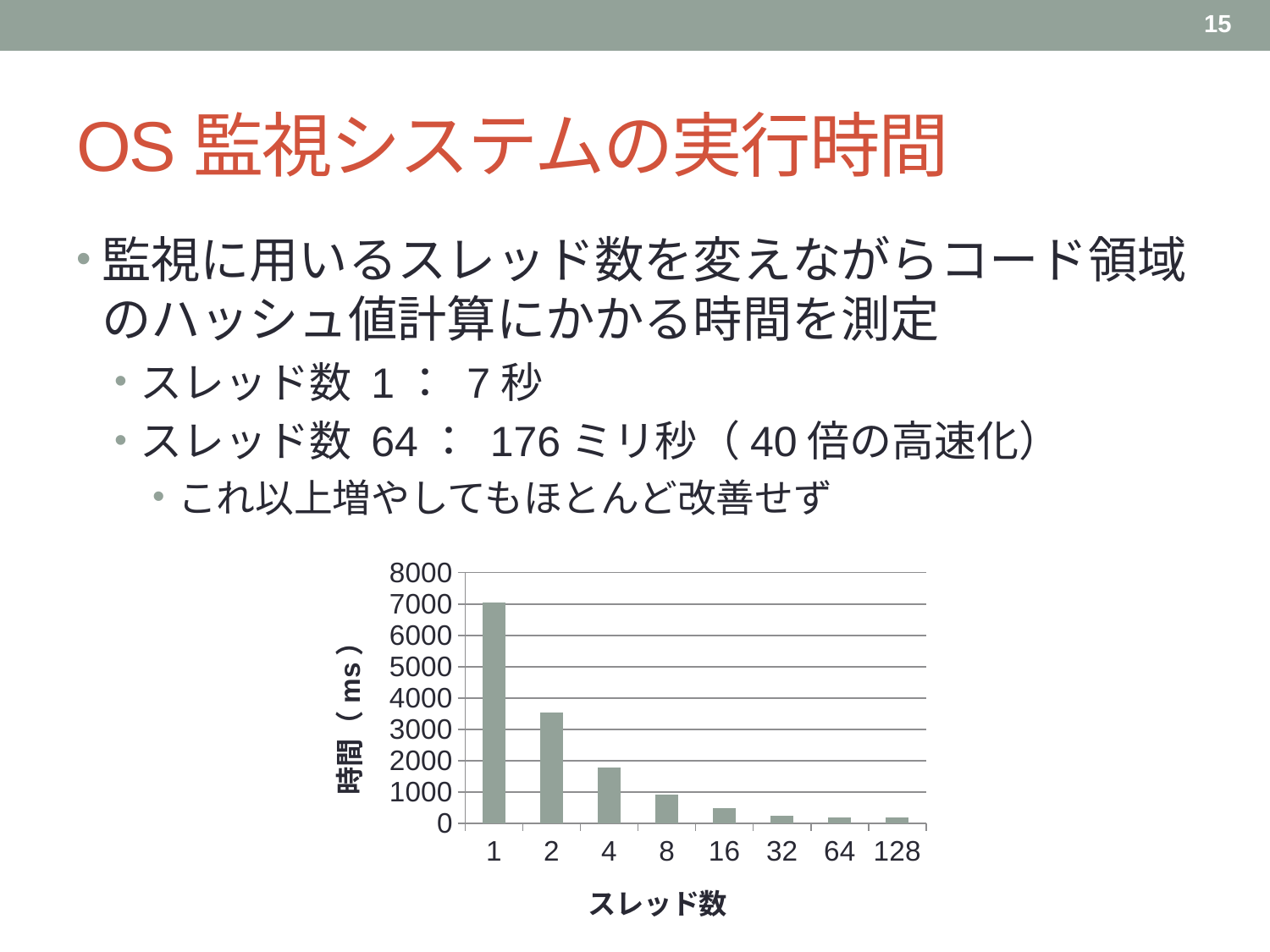
What is the label of the x axis of the chart? スレッド数 What kind of chart is shown on the slide? bar chart Is the execution time for 16 threads greater or less than 1000 ms? less What is the label of the y axis of the chart? 時間（ms） Is the execution time for 2 threads greater or less than 3000 ms? greater Is the execution time for 1 thread greater or less than 6000 ms? greater Which thread count has the highest execution time in the chart? 1 Which has a larger execution time in the chart, 2 threads or 8 threads? 2 threads Do the execution times rise or fall as the thread count increases along the x axis? fall How many thread-count categories are plotted on the x axis of the chart? 8